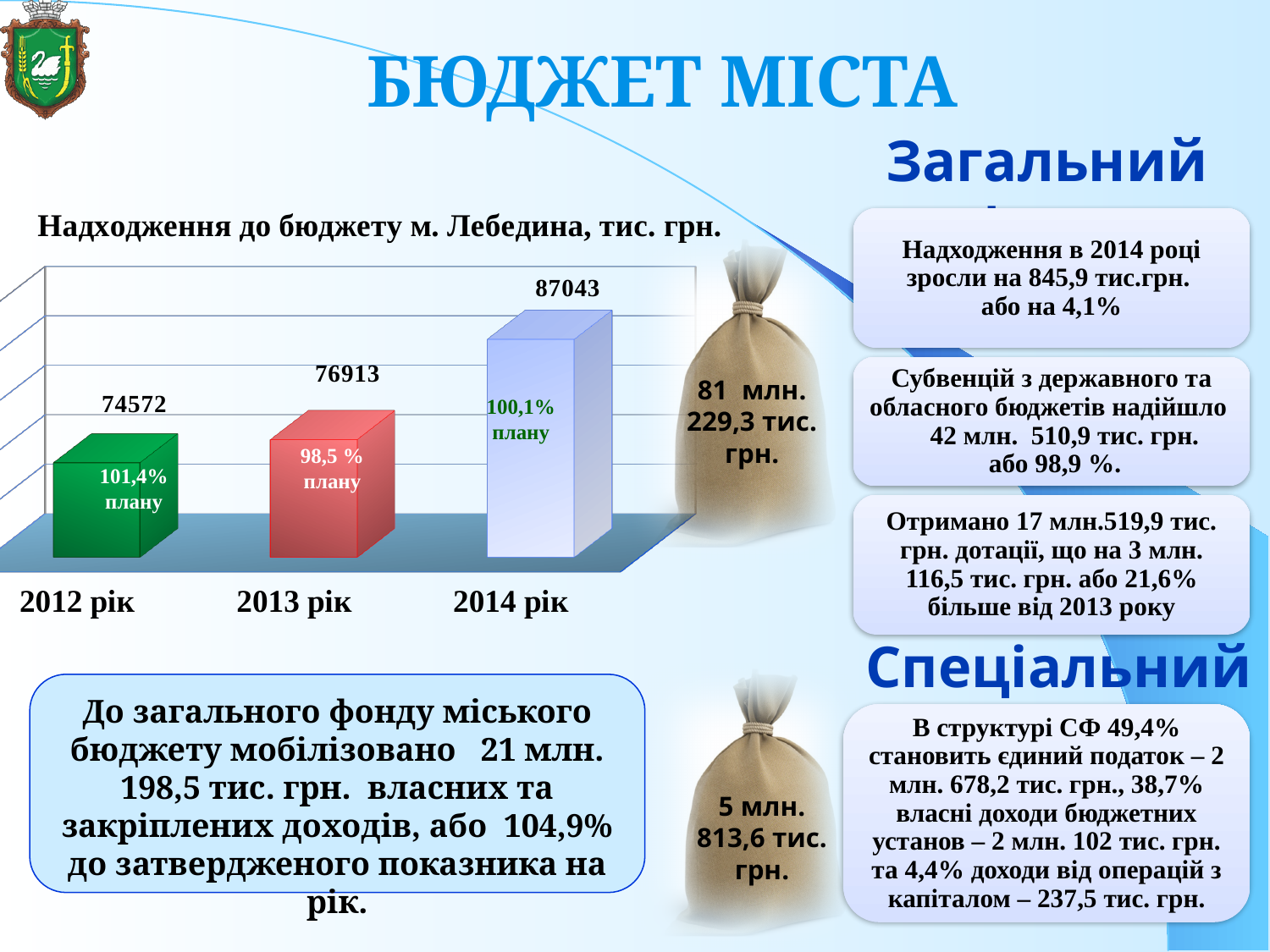
What is the value for 2012 рік in the chart? 74572 How many years (categories) are shown in the chart? 3 What kind of chart is shown on the slide? bar chart What percentage of plan is printed on the bar for 2013 рік? 98,5 % плану Do the values rise or fall from 2012 рік to 2014 рік? rise What is the value for 2014 рік in the chart 'Надходження до бюджету м. Лебедина, тис. грн.'? 87043 What is the difference between the values for 2014 рік and 2013 рік? 10130 Which year has the lowest value in the chart? 2012 рік Which is larger, the value for 2013 рік or the value for 2012 рік? 2013 рік What is the value for 2013 рік in the chart? 76913 Which year has the highest value in the chart? 2014 рік What is the difference between the values for 2013 рік and 2012 рік? 2341